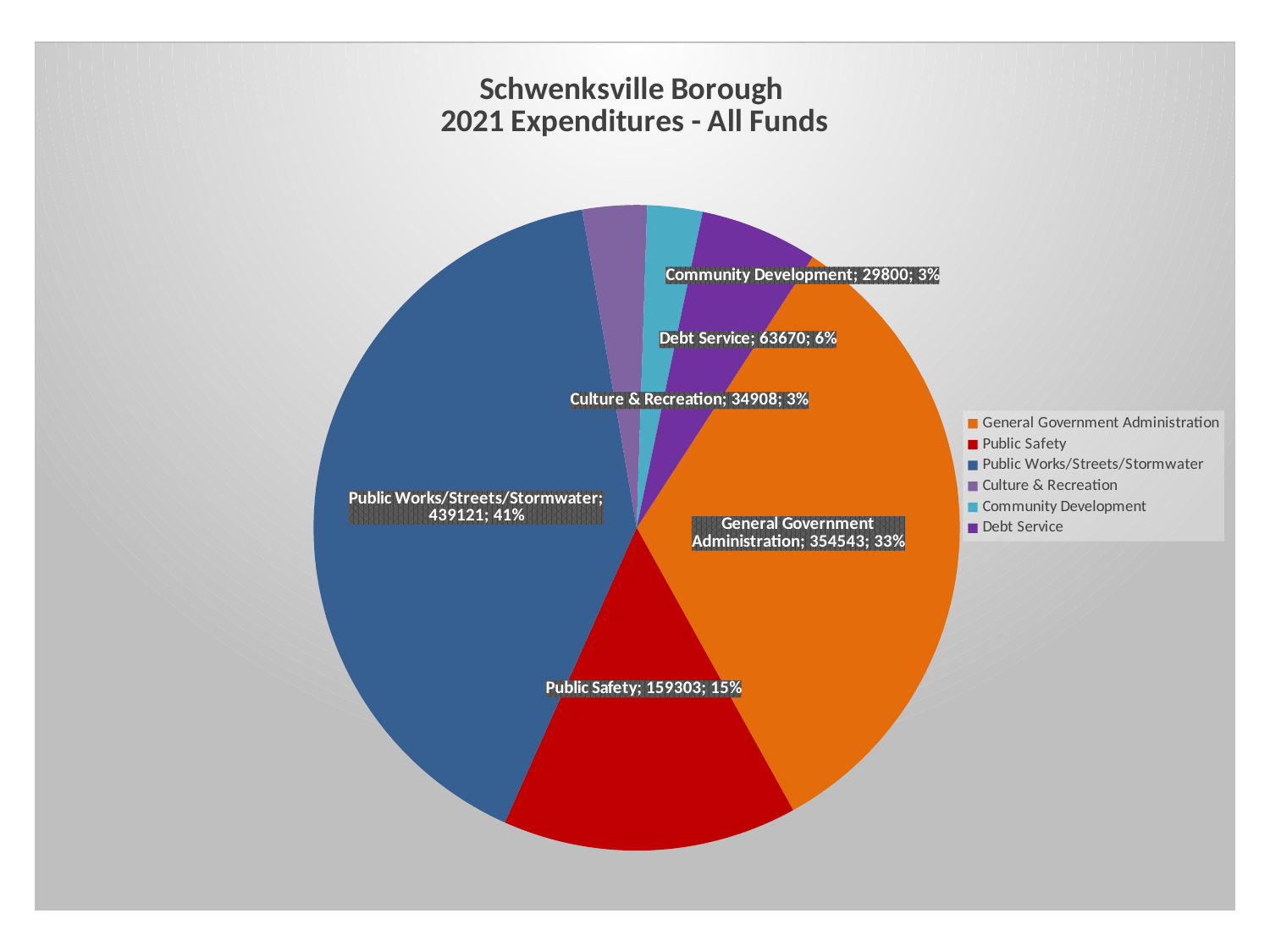
What is the title of the chart? Schwenksville Borough 2021 Expenditures - All Funds Which is larger, the expenditure for Debt Service or for Culture & Recreation? Debt Service What is the expenditure value for Debt Service? 63670 What is the expenditure value for Public Works/Streets/Stormwater? 439121 What is the difference between the Public Works/Streets/Stormwater and General Government Administration expenditures? 84578 How many entries does the legend list? 6 What type of chart is shown on the slide? Pie chart How many categories are shown in the pie chart? 6 Which category has the largest expenditure? Public Works/Streets/Stormwater Which category has the smallest expenditure? Community Development What percentage share of expenditures does General Government Administration represent? 33% What percentage share of expenditures does Public Safety represent? 15%